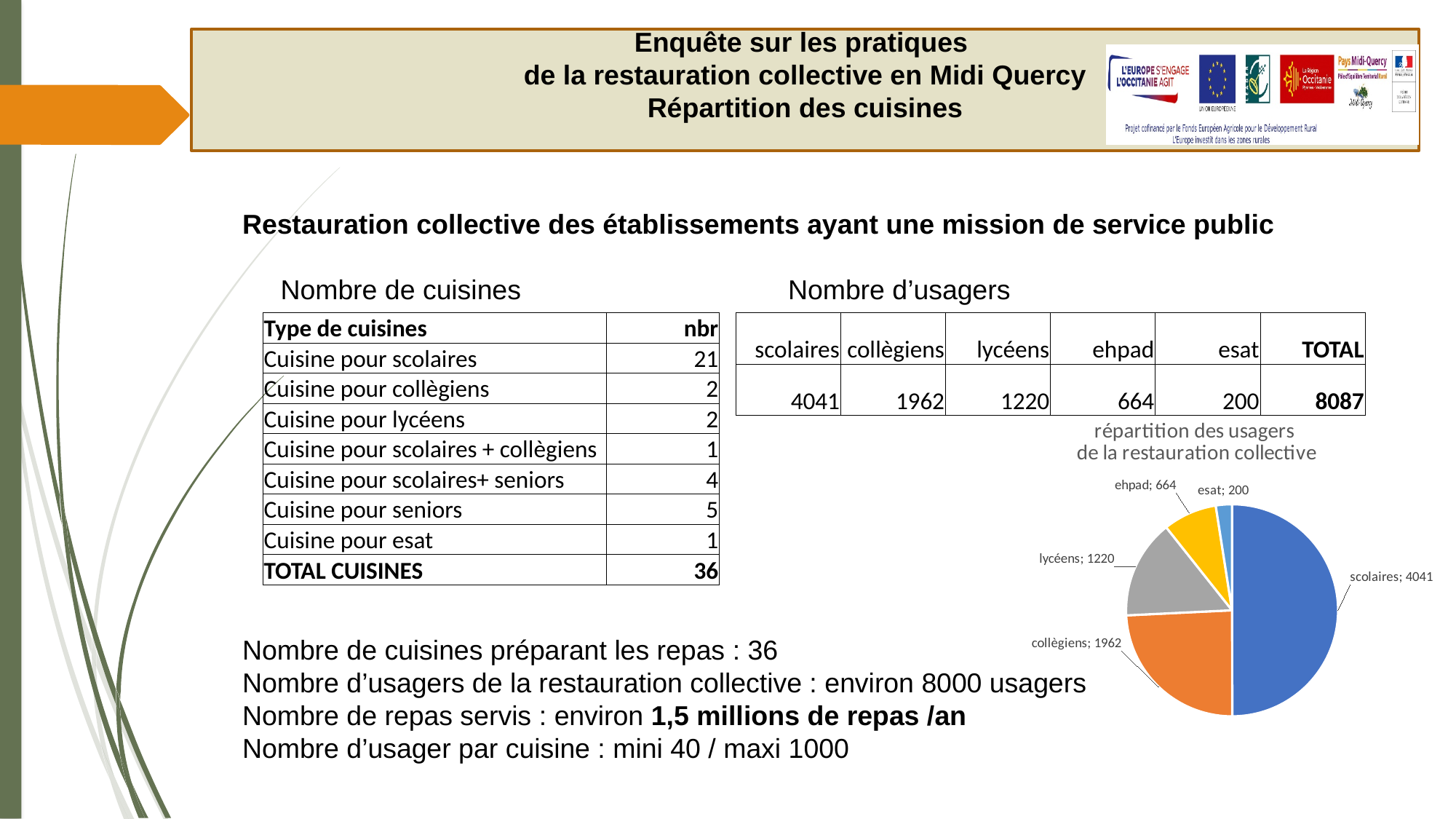
What is the value for lycéens in the pie chart? 1220 Which category has the smallest slice in the pie chart? esat Which is larger in the pie chart, collègiens or lycéens? collègiens What is the value for scolaires in the pie chart? 4041 How many slices does the pie chart have? 5 What is the value for collègiens in the pie chart? 1962 What kind of chart is shown on the slide? pie chart What is the value for esat in the pie chart? 200 What is the value for ehpad in the pie chart? 664 What is the difference between the values for scolaires and collègiens in the pie chart? 2079 Which category has the largest slice in the pie chart? scolaires What is the title of the pie chart? répartition des usagers de la restauration collective